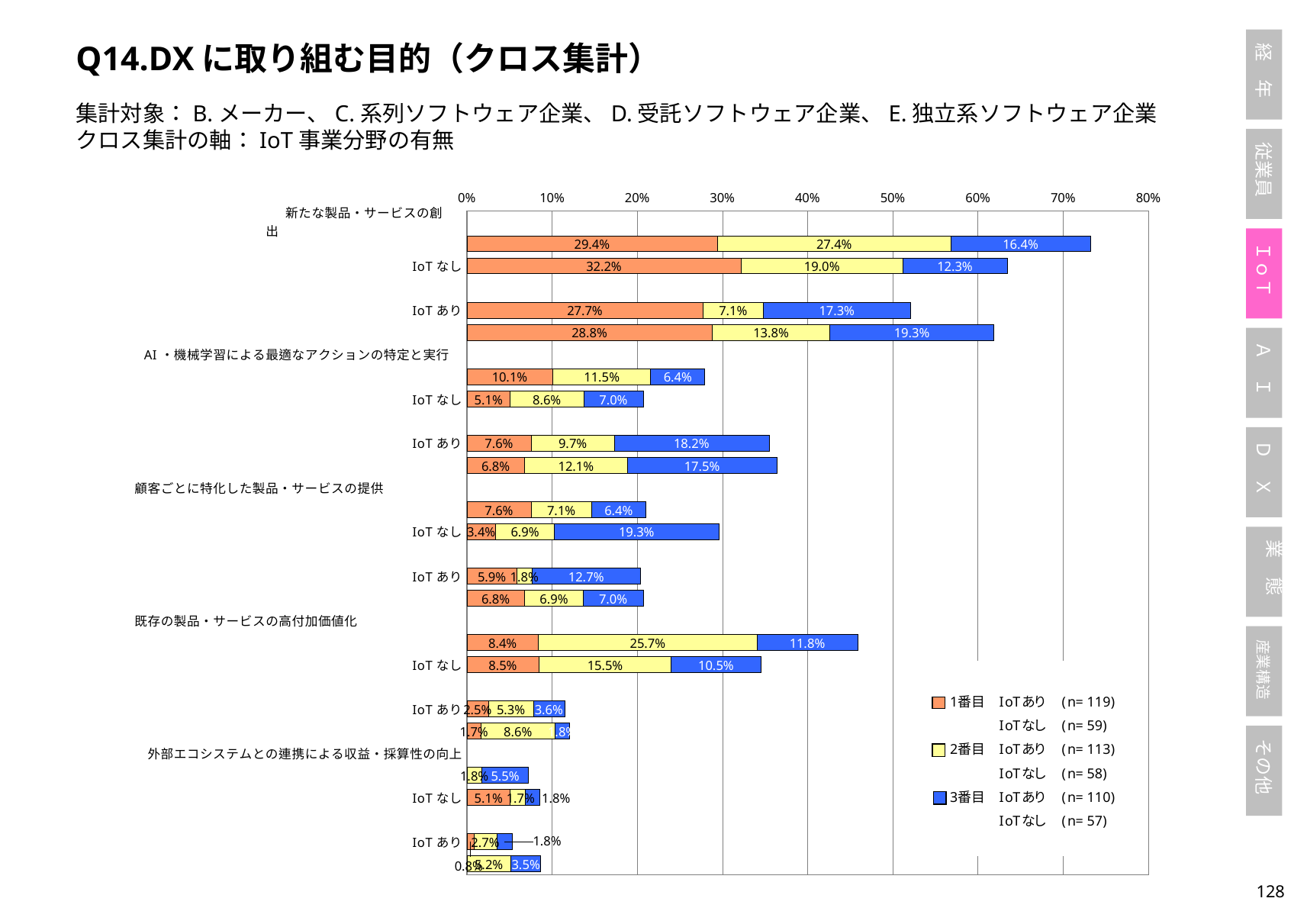
What is the 3番目 value for the third bar from the top, labeled IoT あり (the one starting with 27.7%)? 17.3% How many series does the legend list (1番目, 2番目, 3番目)? 3 What is the 1番目 value for the topmost bar in the chart? 29.4% Which has the larger 1番目 value: the topmost bar or the second bar from the top (IoT なし)? the second bar (IoT なし), 32.2% What is the 1番目 value for the second bar from the top, labeled IoT なし? 32.2% What kind of chart is shown on the slide? bar chart What is the maximum value shown on the horizontal axis? 80% According to the legend, what is the n for 1番目 IoTあり? 119 What is the total of the second bar from the top (32.2%, 19.0%, 12.3%)? 63.5% What is the 3番目 value for the topmost bar in the chart? 16.4% What is the difference between the 2番目 values of the topmost bar (27.4%) and the second bar (19.0%)? 8.4 percentage points What is the total of the topmost stacked bar (29.4%, 27.4%, 16.4%)? 73.2%